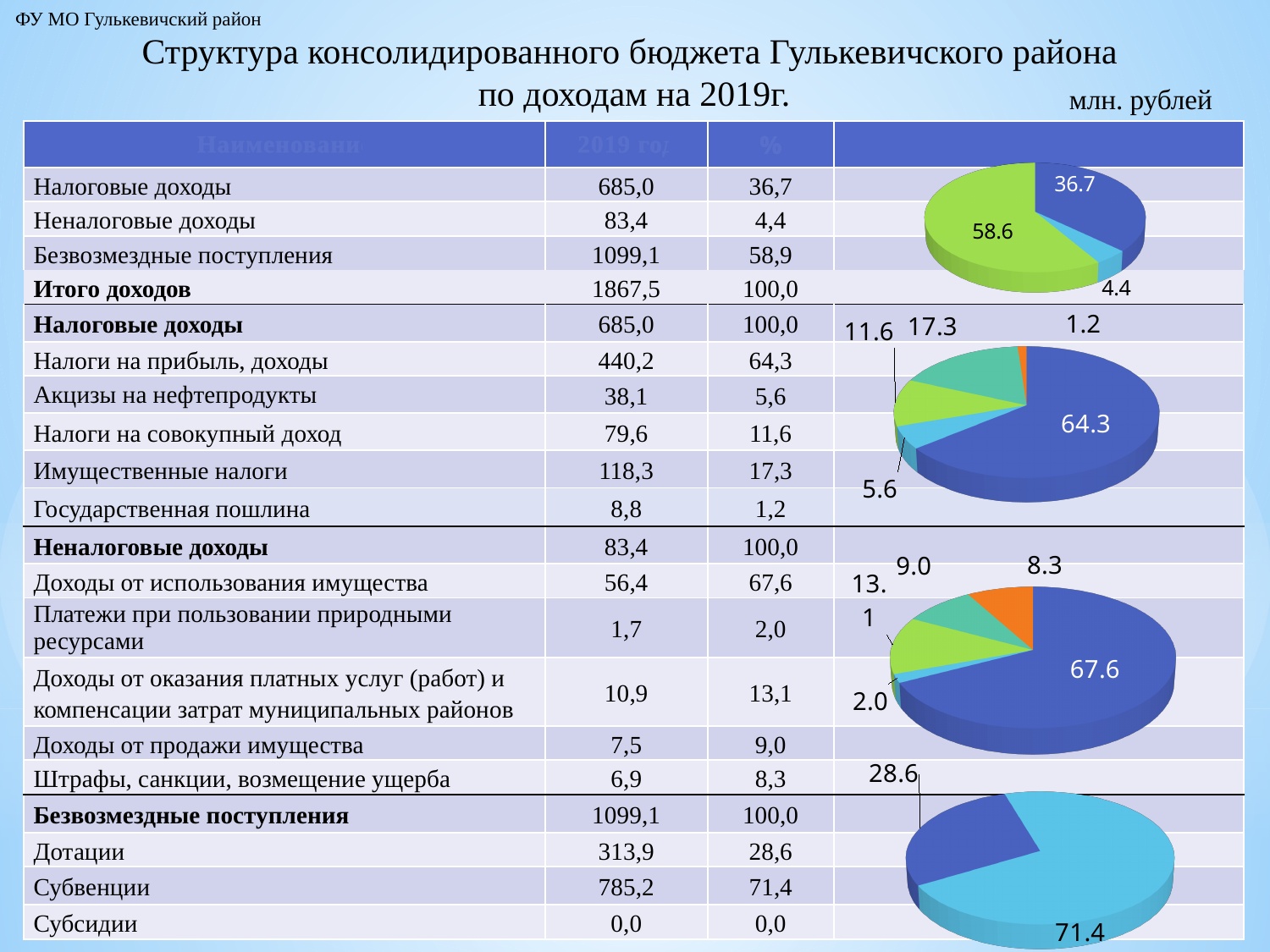
In the third pie chart from the top, what is the value of the smallest slice? 2.0 In the bottom pie chart, what is the difference between the two slice values, 71.4 and 28.6? 42.8 In the third pie chart from the top, which slice is larger, the one labelled 9.0 or the one labelled 8.3? 9.0 What kind of chart is the top chart on the right side of the slide? pie chart How many slices does the third pie chart from the top have? 5 In the top pie chart, what value is shown on the largest (green) slice? 58.6 In the top pie chart, what is the value of the smallest slice? 4.4 In the second pie chart from the top, what is the value of the largest slice? 64.3 How many slices does the second pie chart from the top have? 5 In the bottom pie chart, what is the value of the largest slice? 71.4 How many slices does the bottom pie chart on the slide have? 2 In the second pie chart from the top, what is the value of the smallest slice? 1.2